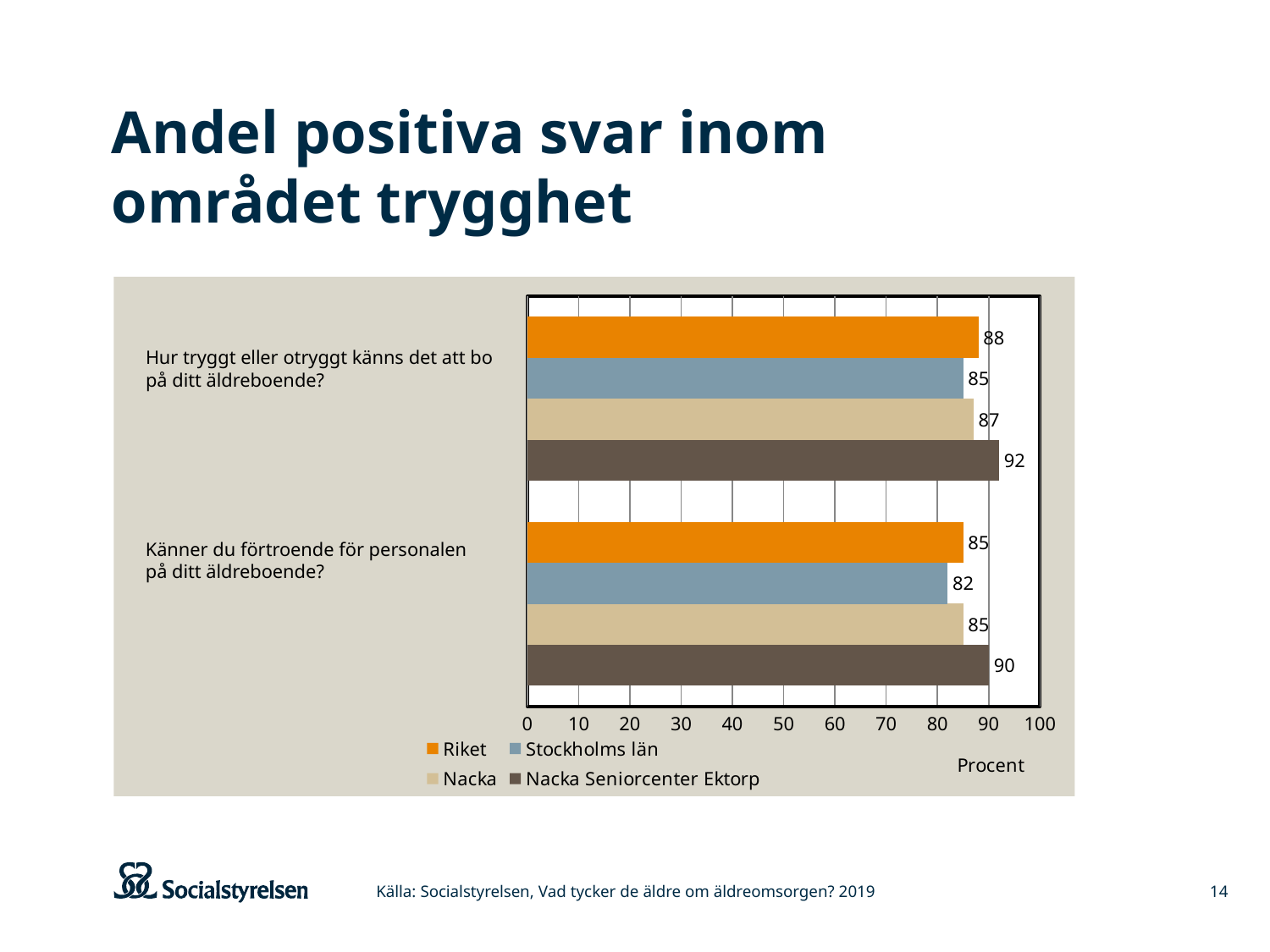
How many series does the legend list? 4 What kind of chart is shown on the slide? Bar chart What is the value for Riket for the question "Hur tryggt eller otryggt känns det att bo på ditt äldreboende?"? 88 What is the value for Stockholms län for the question "Känner du förtroende för personalen på ditt äldreboende?"? 82 What is the value for Nacka Seniorcenter Ektorp for the question "Hur tryggt eller otryggt känns det att bo på ditt äldreboende?"? 92 Which is larger for the question "Hur tryggt eller otryggt känns det att bo på ditt äldreboende?": Riket or Nacka? Riket What is the label on the horizontal axis of the chart? Procent Which series has the highest value for the question "Känner du förtroende för personalen på ditt äldreboende?"? Nacka Seniorcenter Ektorp How many survey questions (categories) are shown on the chart? 2 Is the value for Nacka Seniorcenter Ektorp for the question "Känner du förtroende för personalen på ditt äldreboende?" greater or less than 80? greater Which series has the lowest value for the question "Hur tryggt eller otryggt känns det att bo på ditt äldreboende?"? Stockholms län What is the difference between Nacka Seniorcenter Ektorp and Stockholms län for the question "Känner du förtroende för personalen på ditt äldreboende?"? 8